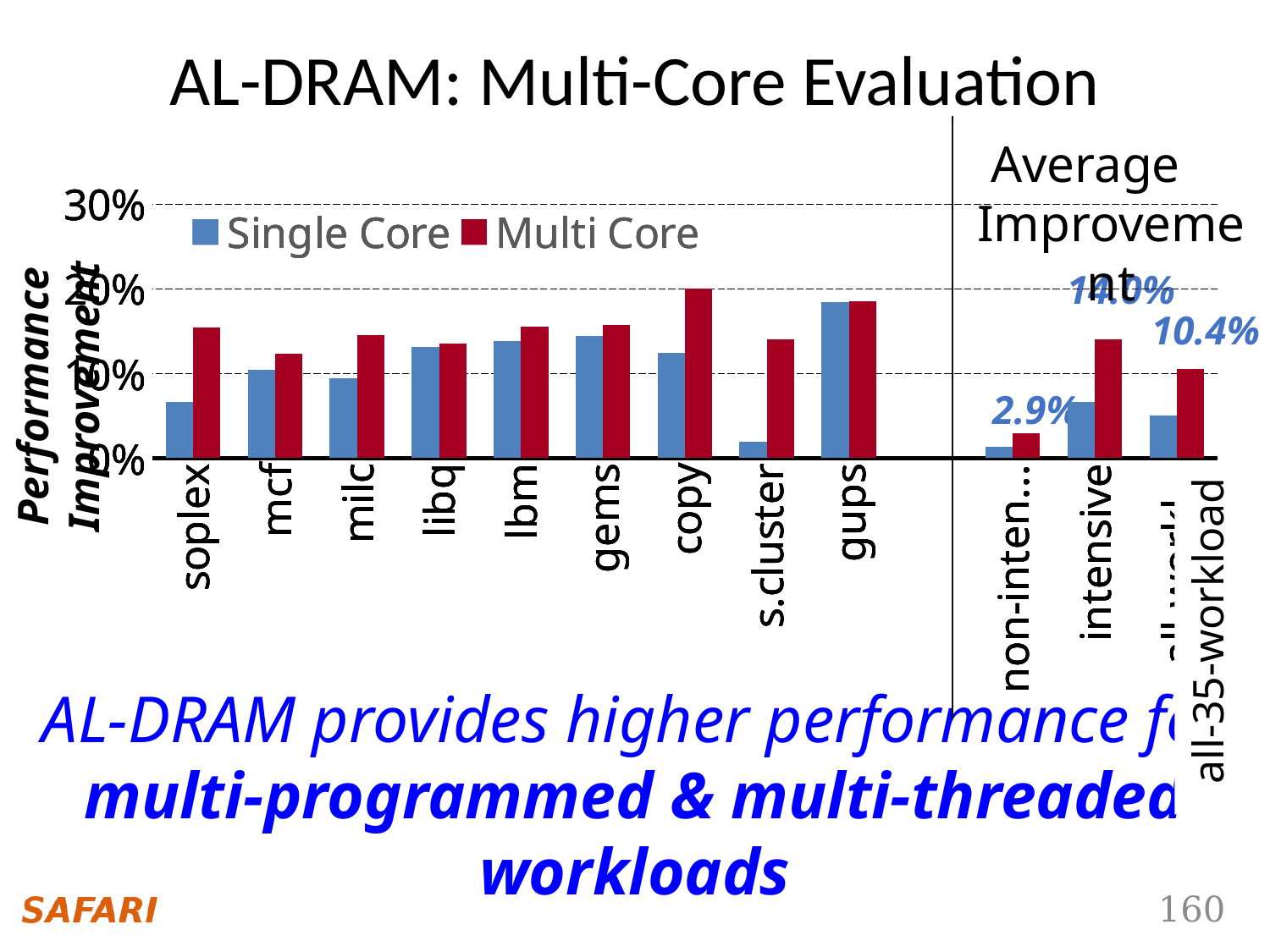
What kind of chart is shown on the slide? bar chart Among the nine benchmarks to the left of the divider, which has the lowest Single Core value? s.cluster Which category has the highest Single Core value? gups How many series does the legend list? 2 Is the Single Core value for s.cluster greater or less than 10%? less For soplex, which is larger: the Single Core value or the Multi Core value? Multi Core What is the Multi Core value labelled for all-35-workload? 10.4% Which category has the highest Multi Core value? copy Is the Multi Core value for copy greater or less than 10%? greater What are the two series named in the legend? Single Core and Multi Core What is the Multi Core value labelled for the non-intensive workload? 2.9% What is the title of the chart? AL-DRAM: Multi-Core Evaluation